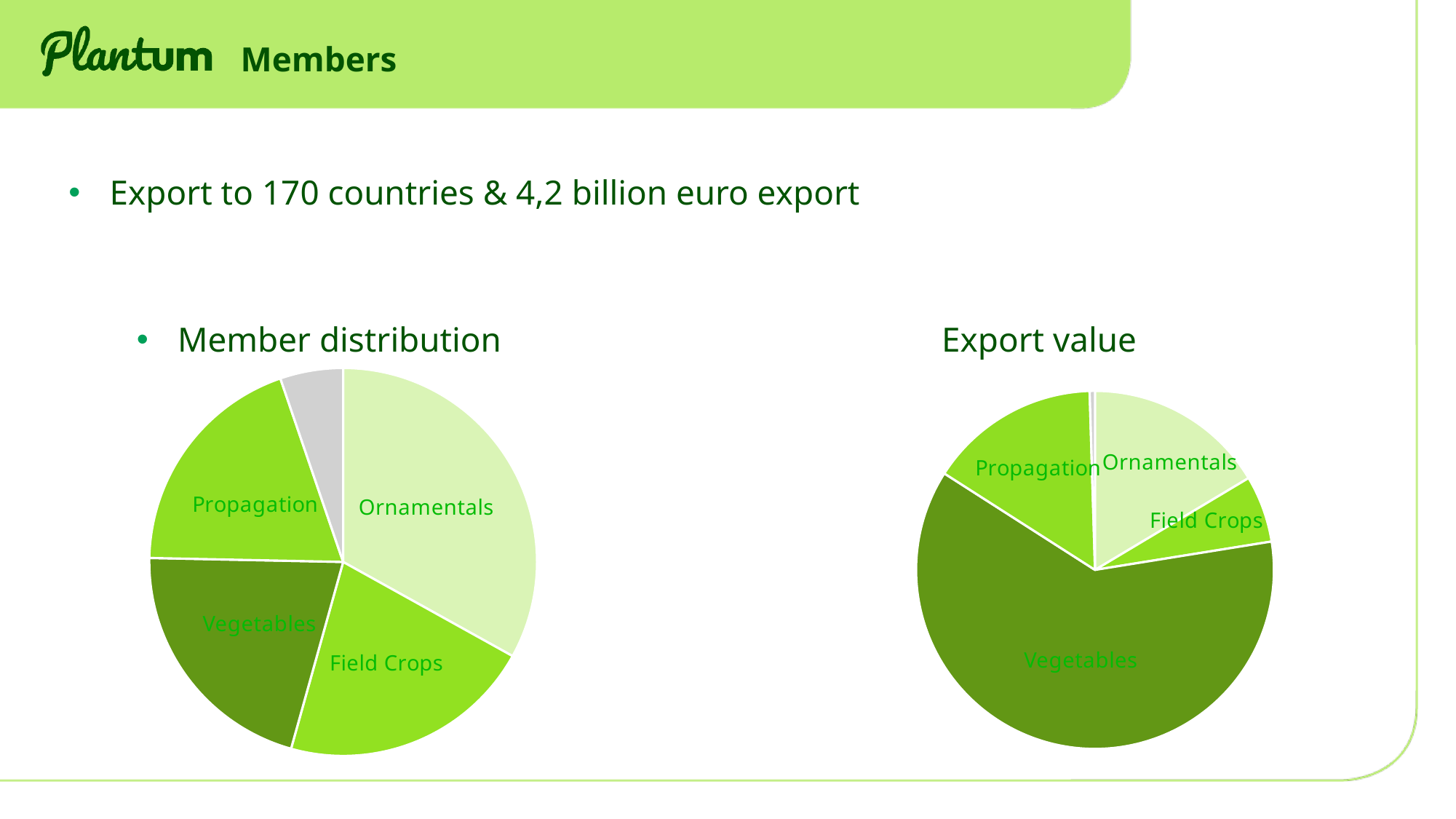
How many labelled slices does the Export value chart have? 4 In the Export value chart, which labelled slice is the smallest? Field Crops What is the title of the pie chart on the right of the slide? Export value In the Member distribution chart, which is larger, Ornamentals or Field Crops? Ornamentals In the Export value chart, which slice is the largest? Vegetables What is the title of the pie chart on the left of the slide? Member distribution In the Member distribution chart, which labelled slice is the largest? Ornamentals How many labelled slices does the Member distribution chart have? 4 What kind of chart is the Export value chart? pie chart In the Export value chart, which is larger, Vegetables or Propagation? Vegetables In the Export value chart, which is larger, Ornamentals or Field Crops? Ornamentals What kind of chart is the Member distribution chart? pie chart